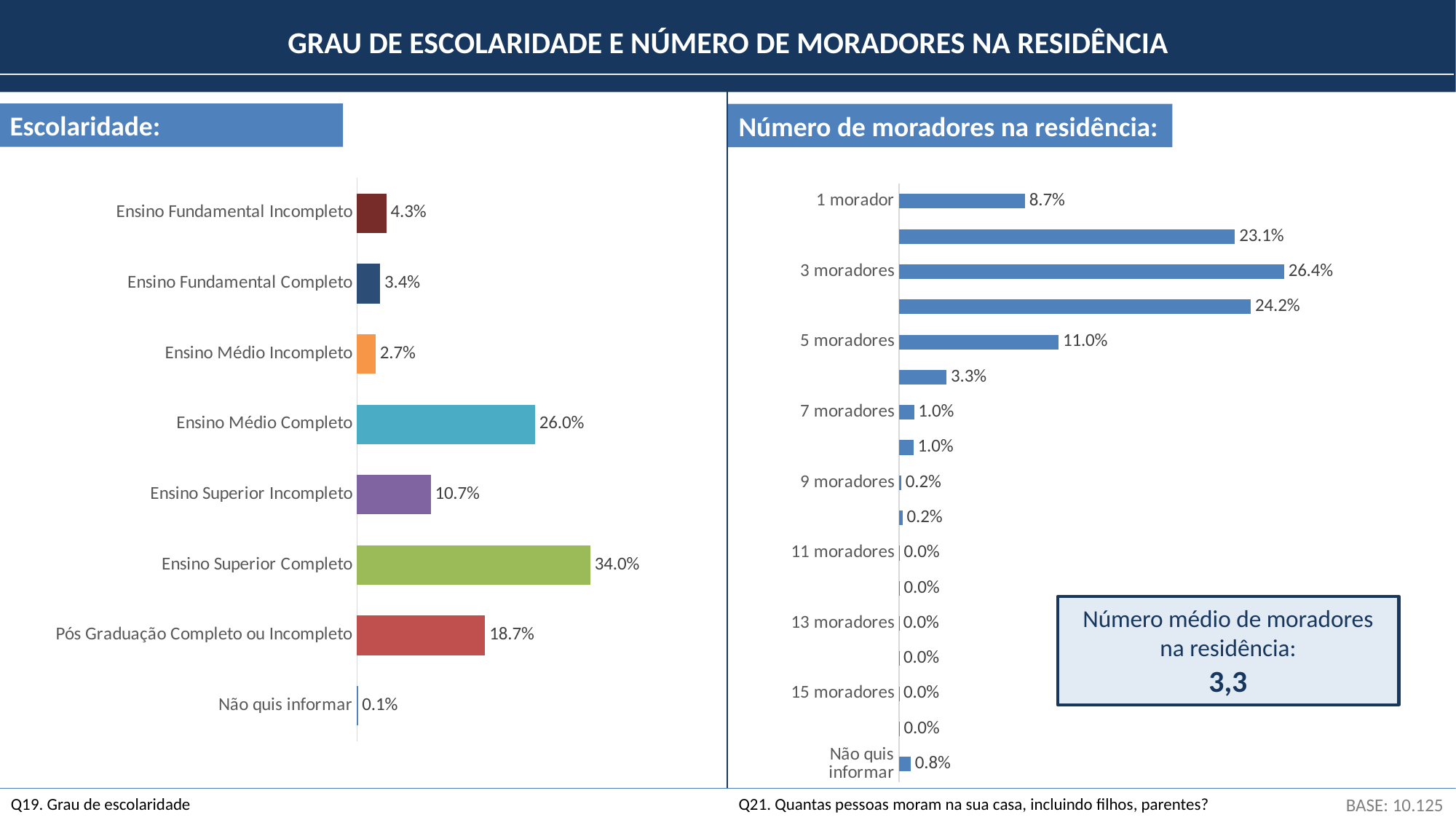
In the Número de moradores na residência chart, which labeled category has the highest value? 3 moradores In the Número de moradores na residência chart, what is the value for 3 moradores? 26.4% In the Escolaridade chart, what is the difference between Ensino Superior Completo and Ensino Médio Completo? 8.0% What type of chart is the Escolaridade chart? Bar chart In the Escolaridade chart, which category has the highest value? Ensino Superior Completo In the Número de moradores na residência chart, what is the difference between 5 moradores and 7 moradores? 10.0% In the Escolaridade chart, which category has the lowest value? Não quis informar How many categories are shown in the Escolaridade chart? 8 In the Número de moradores na residência chart, what is the value for 1 morador? 8.7% In the Escolaridade chart, what is the value for Ensino Superior Completo? 34.0% In the Escolaridade chart, which is larger: Ensino Superior Incompleto or Pós Graduação Completo ou Incompleto? Pós Graduação Completo ou Incompleto In the Escolaridade chart, what is the value for Ensino Médio Incompleto? 2.7%